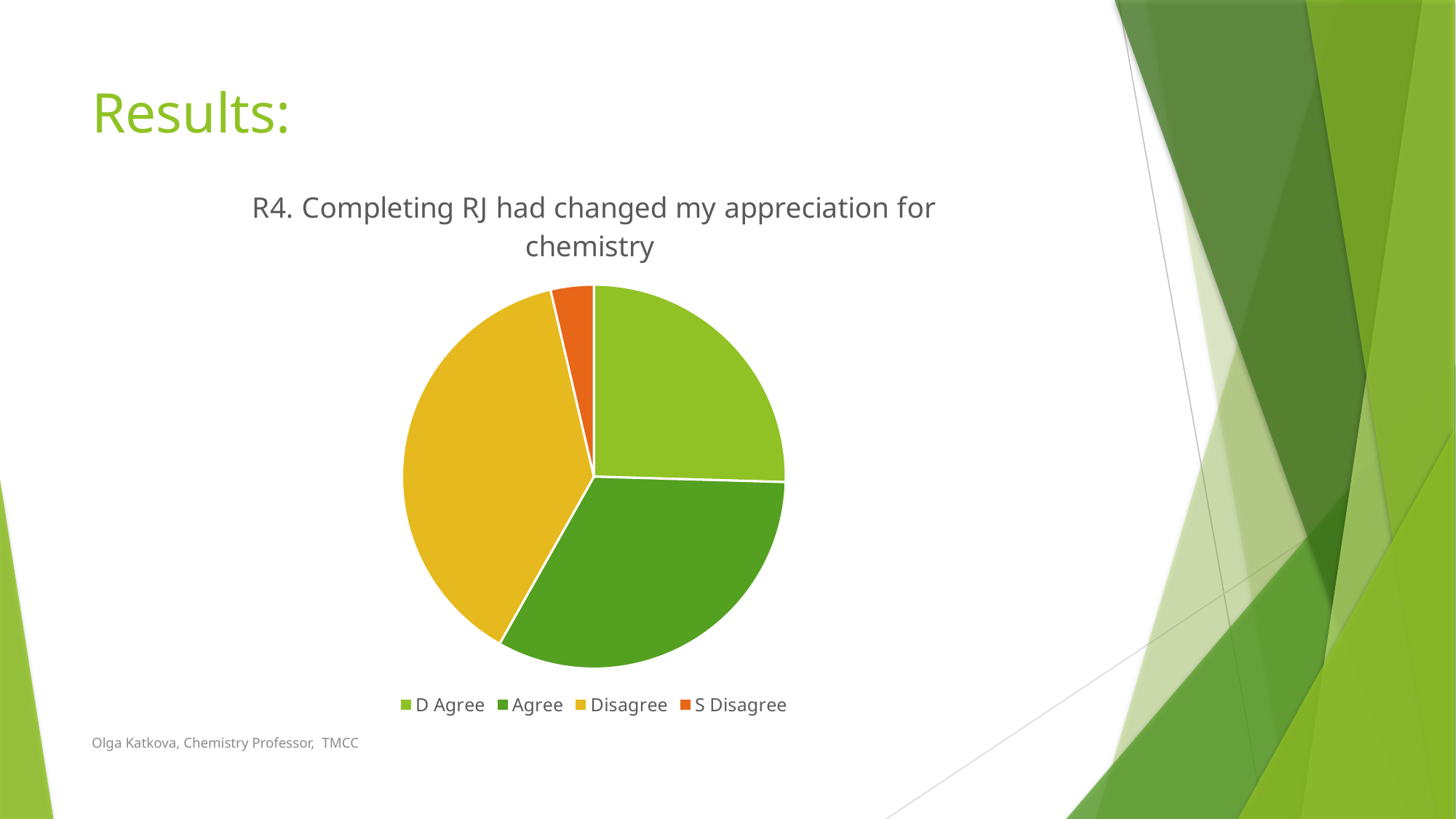
Which category has the largest slice of the pie? Disagree Which slice is larger, Disagree or D Agree? Disagree What is the title of the chart? R4. Completing RJ had changed my appreciation for chemistry What colour is the Disagree slice? Yellow Which category is shown in orange? S Disagree Which slice is larger, S Disagree or D Agree? D Agree Which slice is larger, Agree or D Agree? Agree What kind of chart is shown on the slide? Pie chart Which category has the smallest slice of the pie? S Disagree How many categories does the pie chart have? 4